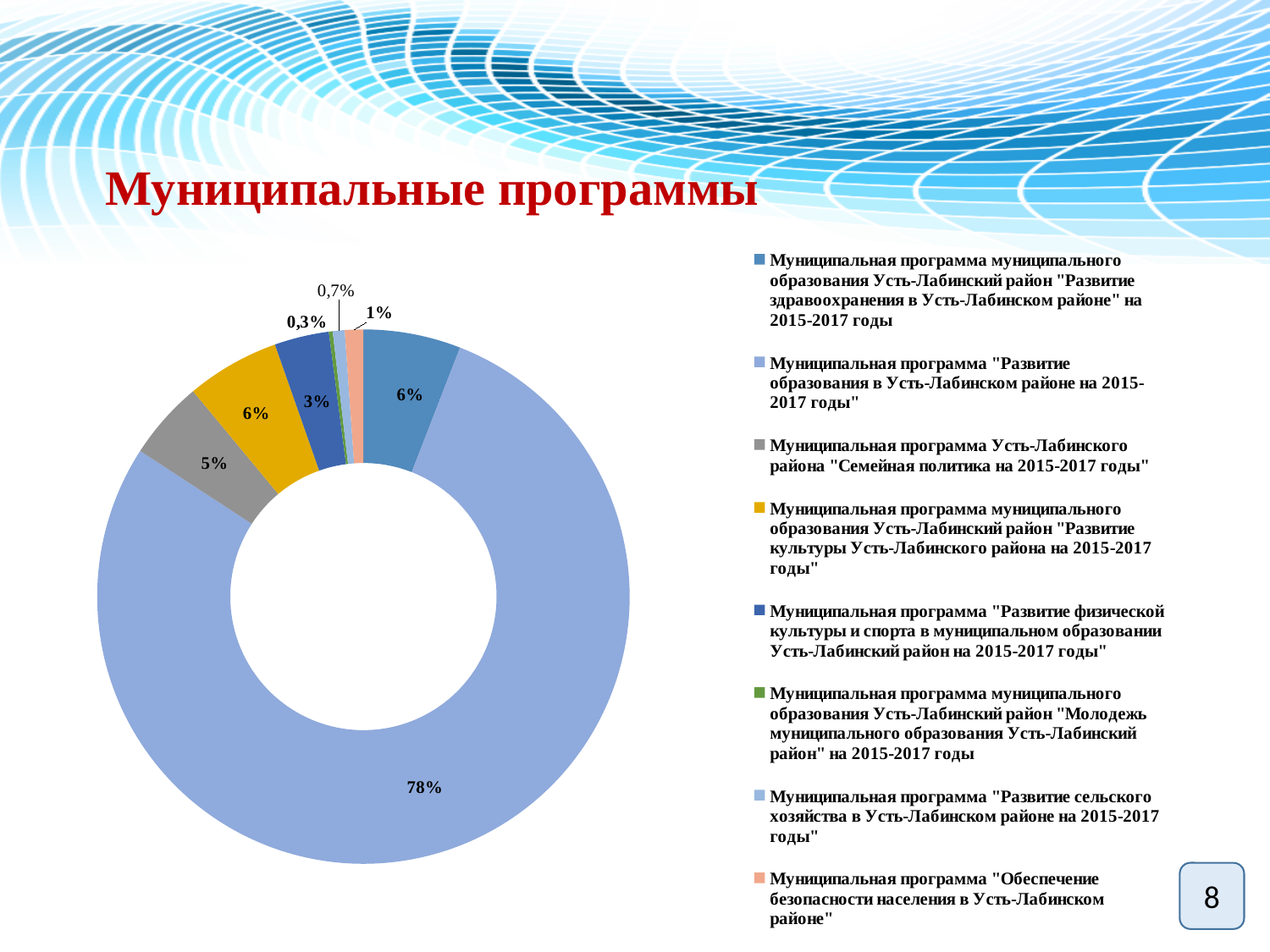
How many programmes (slices) does the legend list? 8 What kind of chart is shown on the slide? Doughnut (pie) chart What share does the programme "Развитие сельского хозяйства в Усть-Лабинском районе" have? 0,7% Which is larger: the share of "Развитие физической культуры и спорта" or "Обеспечение безопасности населения"? Развитие физической культуры и спорта What share does the programme "Обеспечение безопасности населения в Усть-Лабинском районе" have? 1% What share does the programme "Развитие образования в Усть-Лабинском районе на 2015-2017 годы" have in the chart? 78% What share does the programme "Молодежь муниципального образования Усть-Лабинский район" have? 0,3% What share does the programme "Семейная политика на 2015-2017 годы" have? 5% Which programme has the smallest share in the chart? Молодежь муниципального образования Усть-Лабинский район What is the difference between the share of "Развитие образования" (78%) and "Семейная политика" (5%)? 73% What share does the programme "Развитие физической культуры и спорта" have? 3% Which programme has the largest share in the chart? Развитие образования в Усть-Лабинском районе на 2015-2017 годы